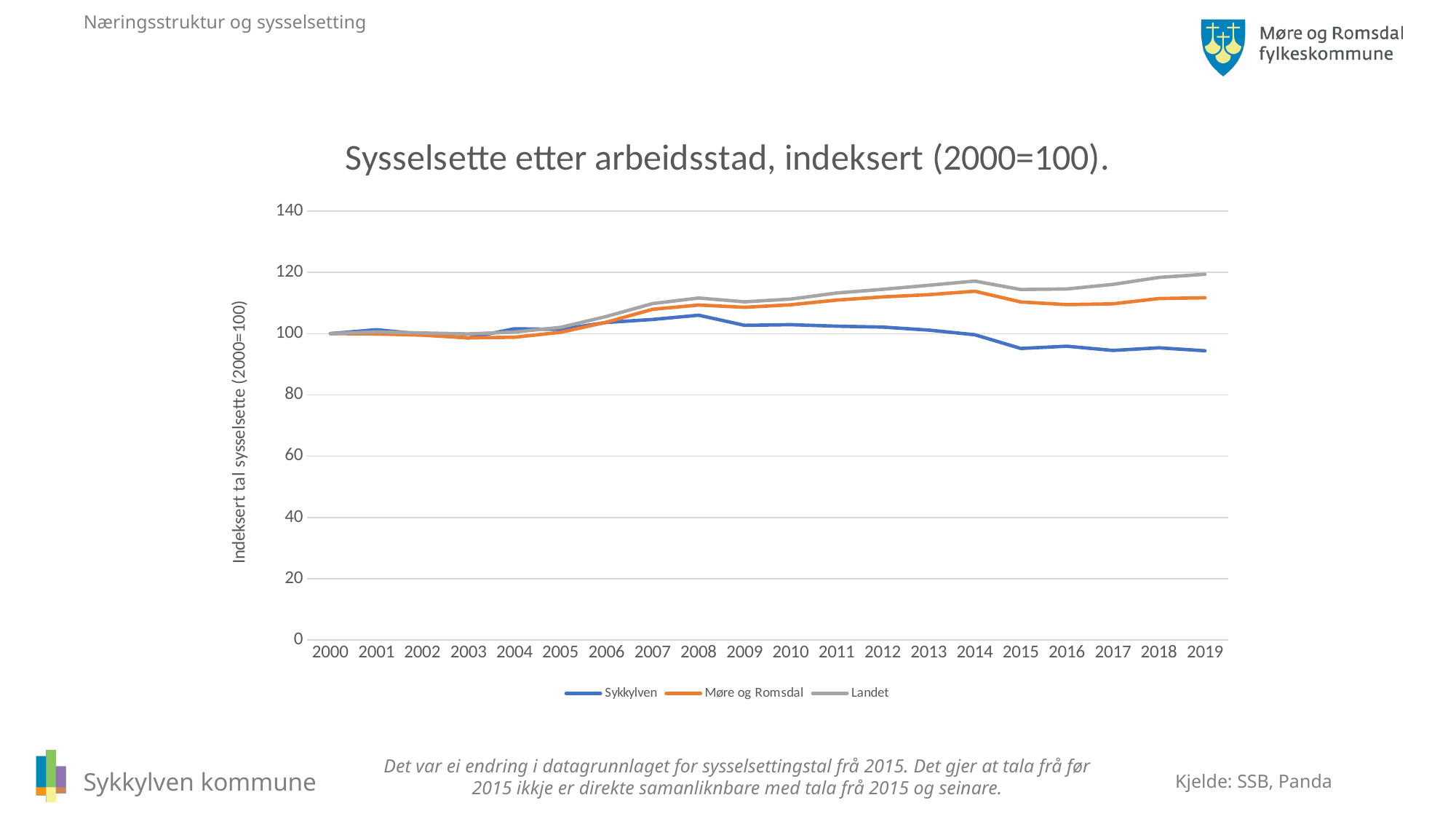
How many years are shown on the x axis? 20 Is the value for Landet in 2019 greater or less than 100? greater Which series has the highest value in 2019? Landet Is the value for Sykkylven in 2019 greater or less than 100? less Is the value for Møre og Romsdal in 2014 greater or less than 100? greater How many series does the legend list? 3 Which series has the lowest value in 2019? Sykkylven What kind of chart is shown on the slide? line chart In 2008, which is higher: Sykkylven or Landet? Landet What is the title of the chart? Sysselsette etter arbeidsstad, indeksert (2000=100). What is the indexed value for Sykkylven in 2000? 100 Does the Sykkylven line rise or fall from 2014 to 2019? fall